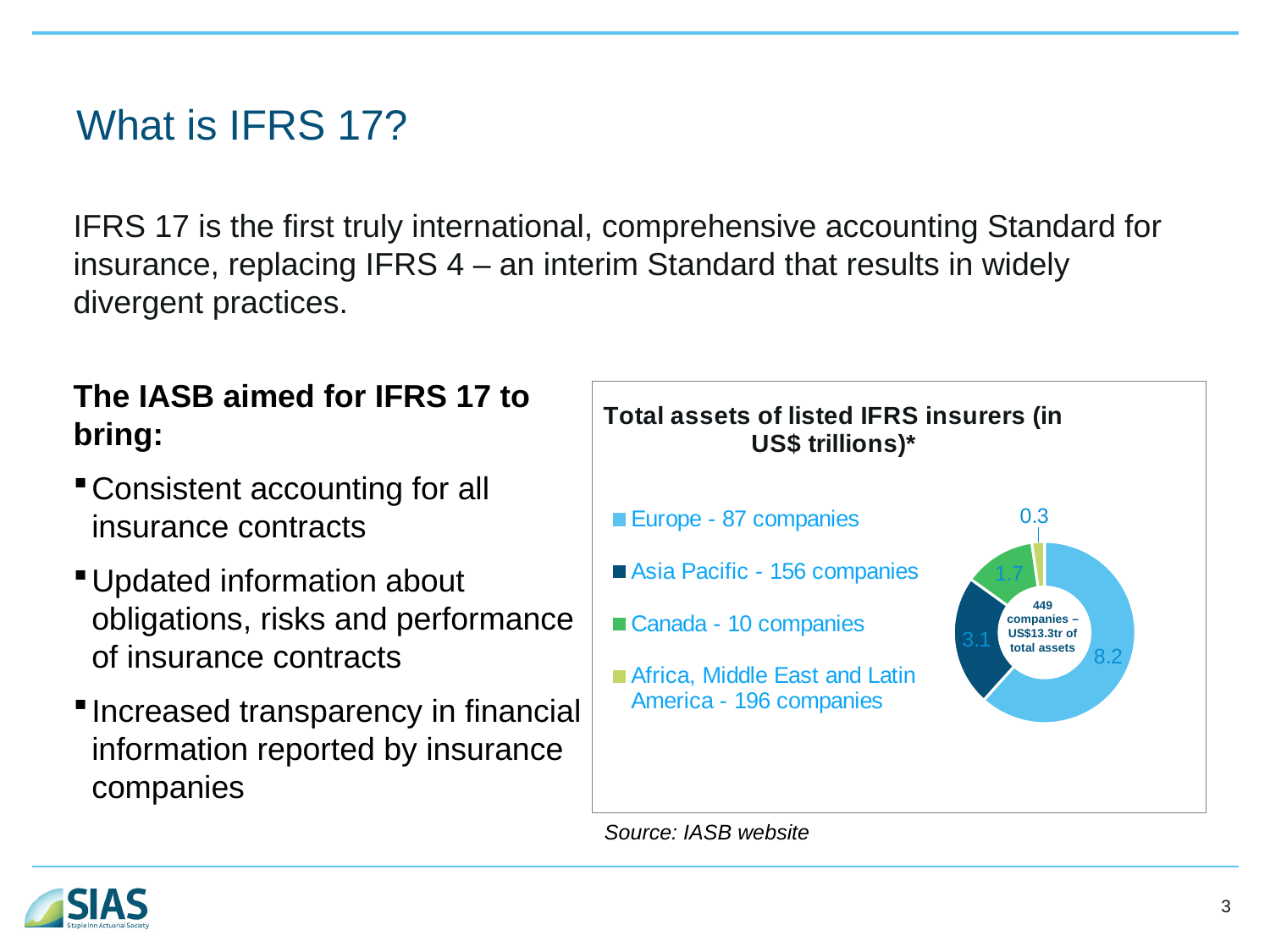
Which is larger, the value for Asia Pacific or the value for Canada? Asia Pacific Which region has the largest total assets? Europe - 87 companies What is the value for Canada - 10 companies? 1.7 What total assets figure is shown in the centre of the chart? US$13.3tr What is the difference between the values for Europe and Asia Pacific? 5.1 What is the value for Europe - 87 companies? 8.2 Which region has the smallest total assets? Africa, Middle East and Latin America - 196 companies What kind of chart is shown on the slide? Pie chart (doughnut) How many regions (slices) does the chart show? 4 What is the value for Africa, Middle East and Latin America - 196 companies? 0.3 What is the title of the chart? Total assets of listed IFRS insurers (in US$ trillions)* What is the value for Asia Pacific - 156 companies? 3.1